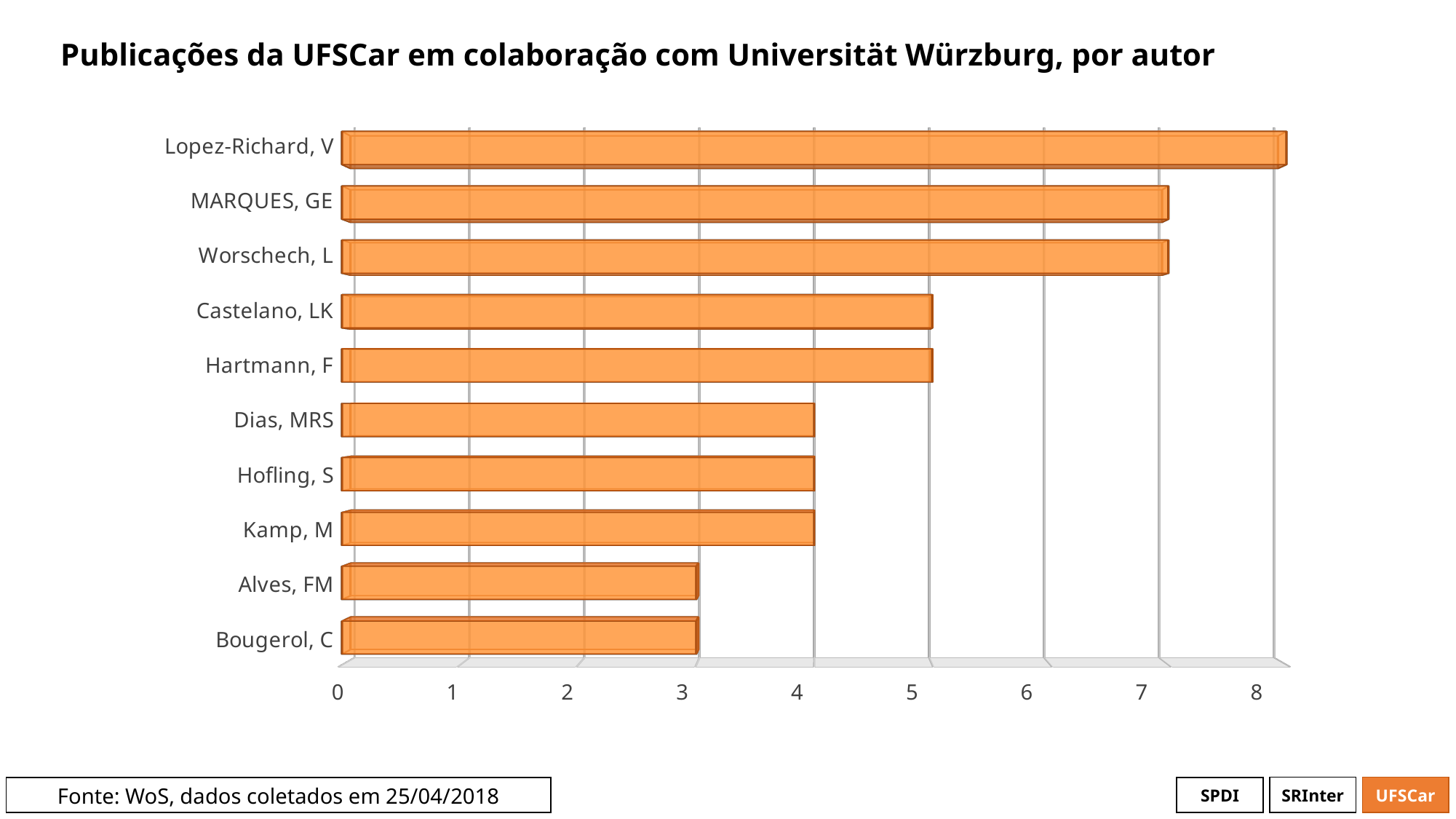
How many publications does Castelano, LK have? 5 What is the difference in publications between Lopez-Richard, V and Bougerol, C? 5 Is the value for Alves, FM greater or less than 4? less How many publications does Bougerol, C have? 3 How many publications does Lopez-Richard, V have? 8 How many authors are listed on the chart? 10 How many publications does Kamp, M have? 4 How many publications does MARQUES, GE have? 7 What kind of chart is shown on the slide? bar chart Is the value for Hartmann, F greater or less than 4? greater Which author has the highest number of publications? Lopez-Richard, V Who has more publications, Worschech, L or Dias, MRS? Worschech, L